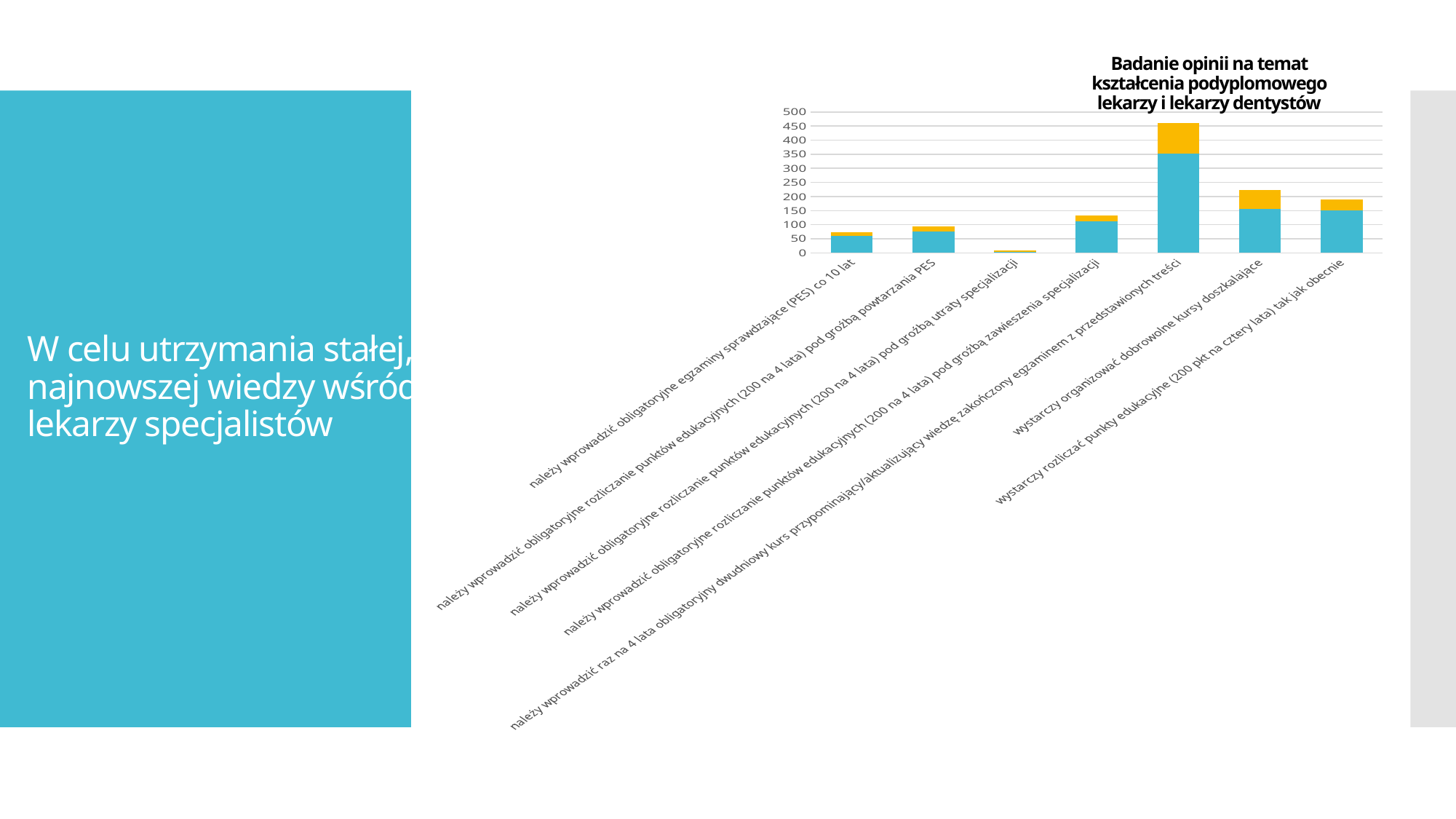
Is the total value of the bar for 'należy wprowadzić obligatoryjne rozliczanie punktów edukacyjnych (200 na 4 lata) pod groźbą zawieszenia specjalizacji' greater or less than 100? greater Which category has the shortest bar in the chart? należy wprowadzić obligatoryjne rozliczanie punktów edukacyjnych (200 na 4 lata) pod groźbą utraty specjalizacji What is the title of the chart? Badanie opinii na temat kształcenia podyplomowego lekarzy i lekarzy dentystów Is the total value of the bar for 'wystarczy organizować dobrowolne kursy doszkalające' greater or less than 200? greater How many categories are plotted on the x axis of the chart? 7 Is the total value of the bar for 'należy wprowadzić raz na 4 lata obligatoryjny dwudniowy kurs przypominający/aktualizujący wiedzę zakończony egzaminem z przedstawionych treści' greater or less than 400? greater What is the maximum value shown on the chart's vertical axis? 500 Which category has the tallest bar in the chart? należy wprowadzić raz na 4 lata obligatoryjny dwudniowy kurs przypominający/aktualizujący wiedzę zakończony egzaminem z przedstawionych treści Which bar is taller: 'wystarczy organizować dobrowolne kursy doszkalające' or 'wystarczy rozliczać punkty edukacyjne (200 pkt na cztery lata) tak jak obecnie'? wystarczy organizować dobrowolne kursy doszkalające Which bar is taller: 'należy wprowadzić obligatoryjne egzaminy sprawdzające (PES) co 10 lat' or 'należy wprowadzić obligatoryjne rozliczanie punktów edukacyjnych (200 na 4 lata) pod groźbą zawieszenia specjalizacji'? należy wprowadzić obligatoryjne rozliczanie punktów edukacyjnych (200 na 4 lata) pod groźbą zawieszenia specjalizacji What kind of chart is shown on the slide? stacked bar chart